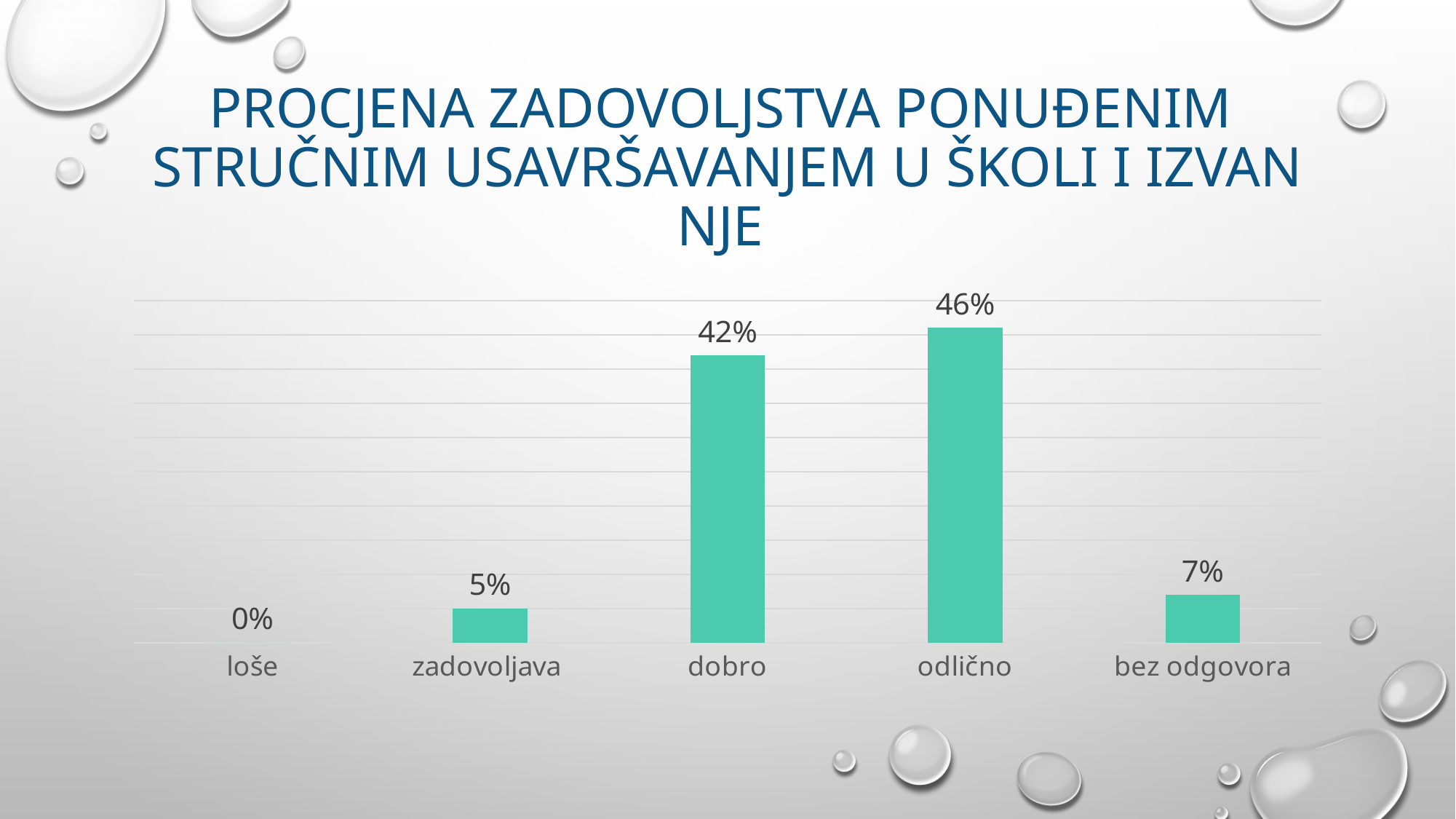
What is the value for "odlično"? 46% Which category has the highest value? odlično What is the value for "bez odgovora"? 7% What is the value for "loše"? 0% What is the value for "zadovoljava"? 5% What kind of chart is shown on the slide? bar chart What is the value for "dobro"? 42% How many categories are shown on the x axis? 5 What is the difference between the values for "odlično" and "dobro"? 4% Which is larger, the value for "bez odgovora" or the value for "zadovoljava"? bez odgovora What is the difference between the values for "dobro" and "zadovoljava"? 37% Which category has the lowest value? loše